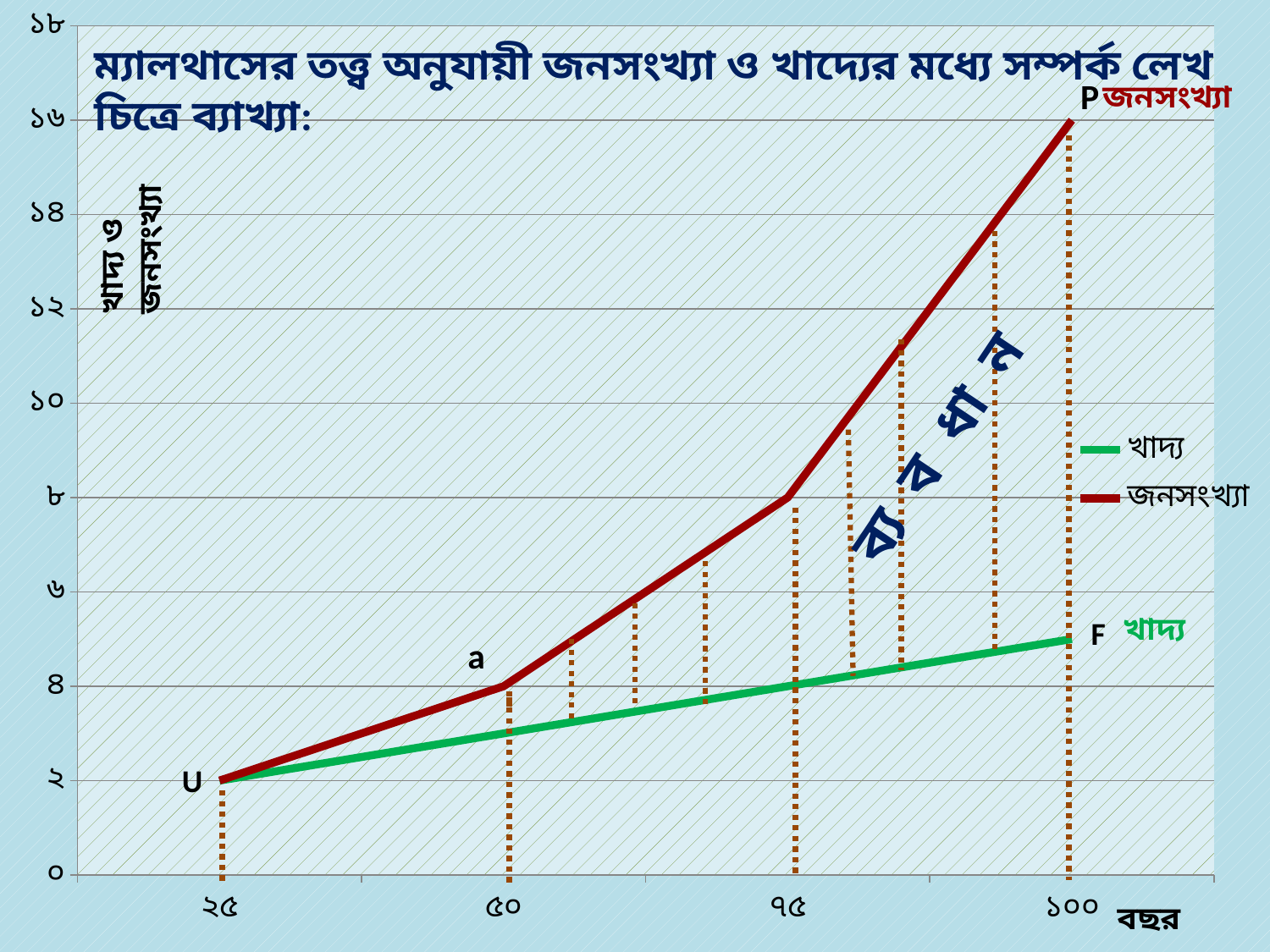
What is the value of খাদ্য at ৭৫ বছর? ৪ Does the জনসংখ্যা line rise or fall as বছর increases? rise What is the difference between জনসংখ্যা and খাদ্য at ৭৫ বছর? ৪ Which colour is used for the জনসংখ্যা line? dark red What is the value of জনসংখ্যা at ১০০ বছর? ১৬ What is the value of জনসংখ্যা at ৫০ বছর? ৪ Is the value of খাদ্য at ১০০ বছর greater or less than ৬? less How many series does the legend list? 2 What are the two series named in the legend? খাদ্য and জনসংখ্যা What kind of chart is shown on the slide? line chart What is the value of খাদ্য at ২৫ বছর? ২ What is the value of জনসংখ্যা at ৭৫ বছর? ৮